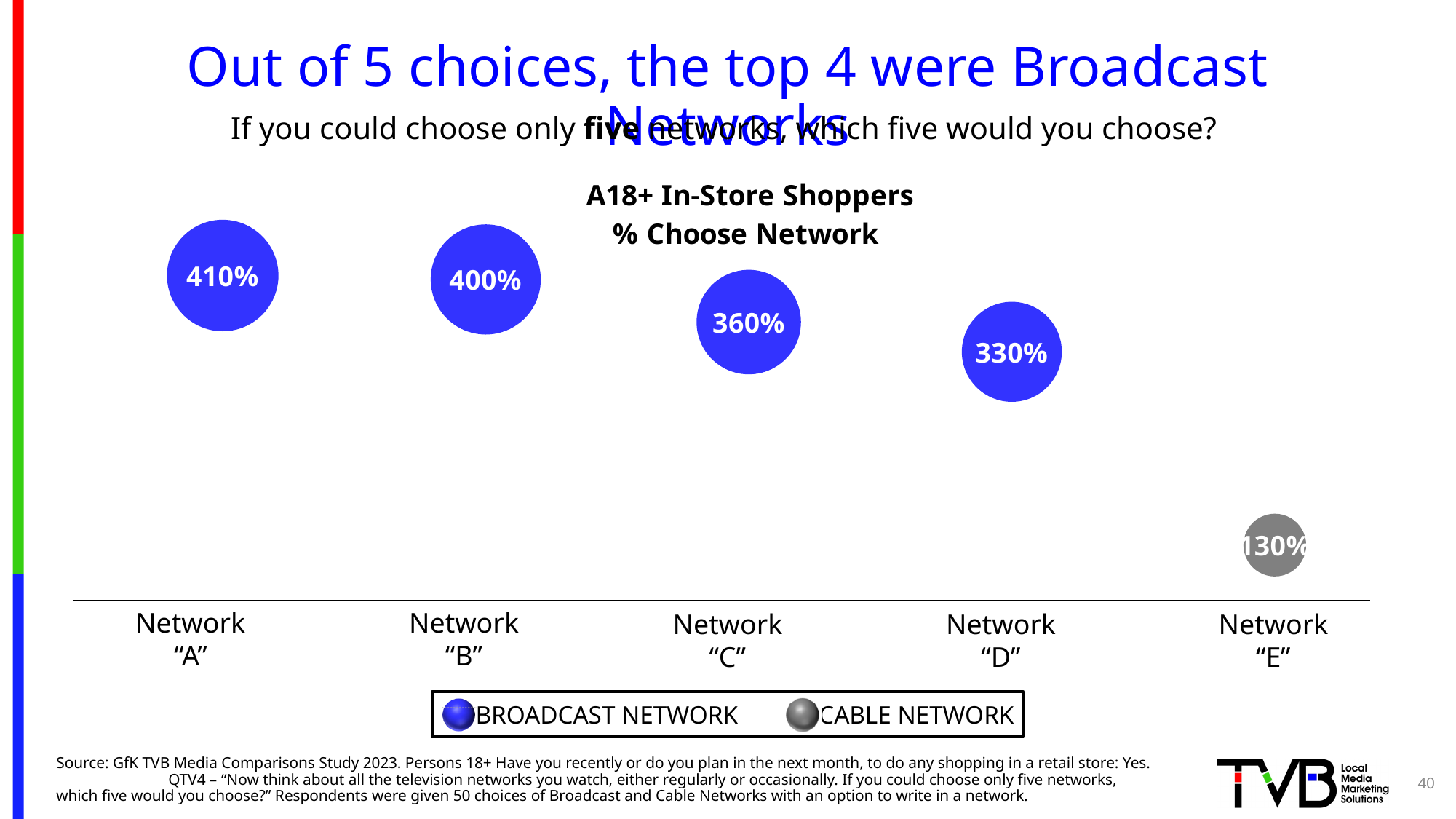
Which is larger, the value for Network "C" or the value for Network "D"? Network "C" What is the difference between the values for Network "A" and Network "E"? 280% What is the difference between the values for Network "B" and Network "D"? 70% What is the value for Network "A"? 410% What is the value for Network "C"? 360% Which network has the lowest value? Network "E" How many networks are shown in the chart? 5 Do the values rise or fall from Network "A" to Network "E"? fall How many entries does the legend list? 2 What is the value for Network "E"? 130% Which network is shown as a Cable Network in the chart? Network "E" Which network has the highest value? Network "A"